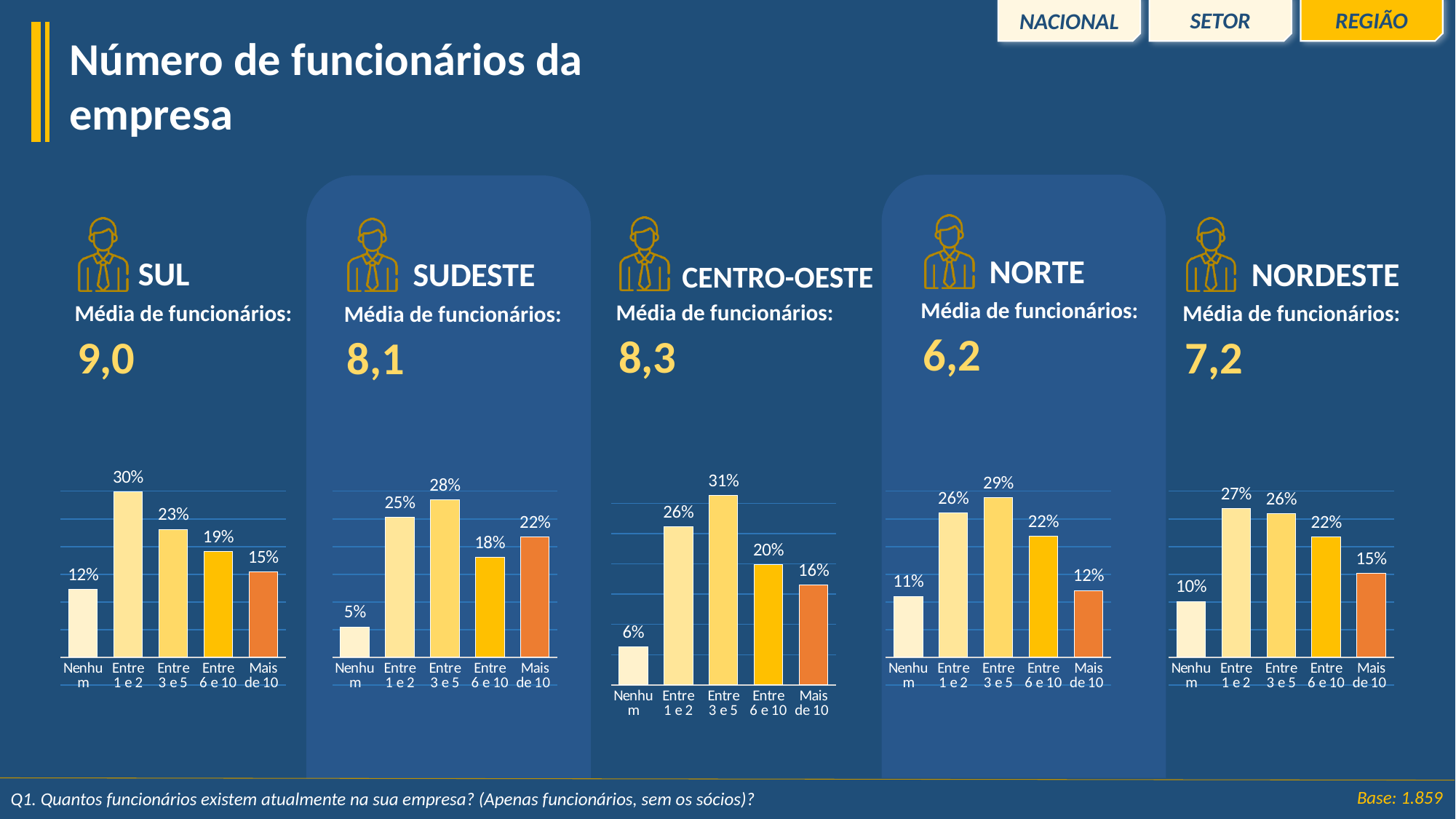
Which region shows the highest 'Média de funcionários' value? SUL How many categories does the SUL chart show? 5 In the SUDESTE chart, what is the value for 'Nenhum'? 5% In the NORTE chart, what is the difference between 'Entre 3 e 5' and 'Entre 6 e 10'? 7% In the NORDESTE chart, what is the difference between 'Entre 1 e 2' and 'Mais de 10'? 12% What kind of chart is used for the NORTE region? Bar chart In the NORTE chart, which category has the lowest value? Nenhum In the SUL chart, what is the value for 'Entre 1 e 2'? 30% In the CENTRO-OESTE chart, what is the value for 'Mais de 10'? 16% What is the 'Média de funcionários' shown for NORDESTE? 7,2 In the CENTRO-OESTE chart, which category has the highest value? Entre 3 e 5 In the SUDESTE chart, which is larger: 'Entre 6 e 10' or 'Mais de 10'? Mais de 10